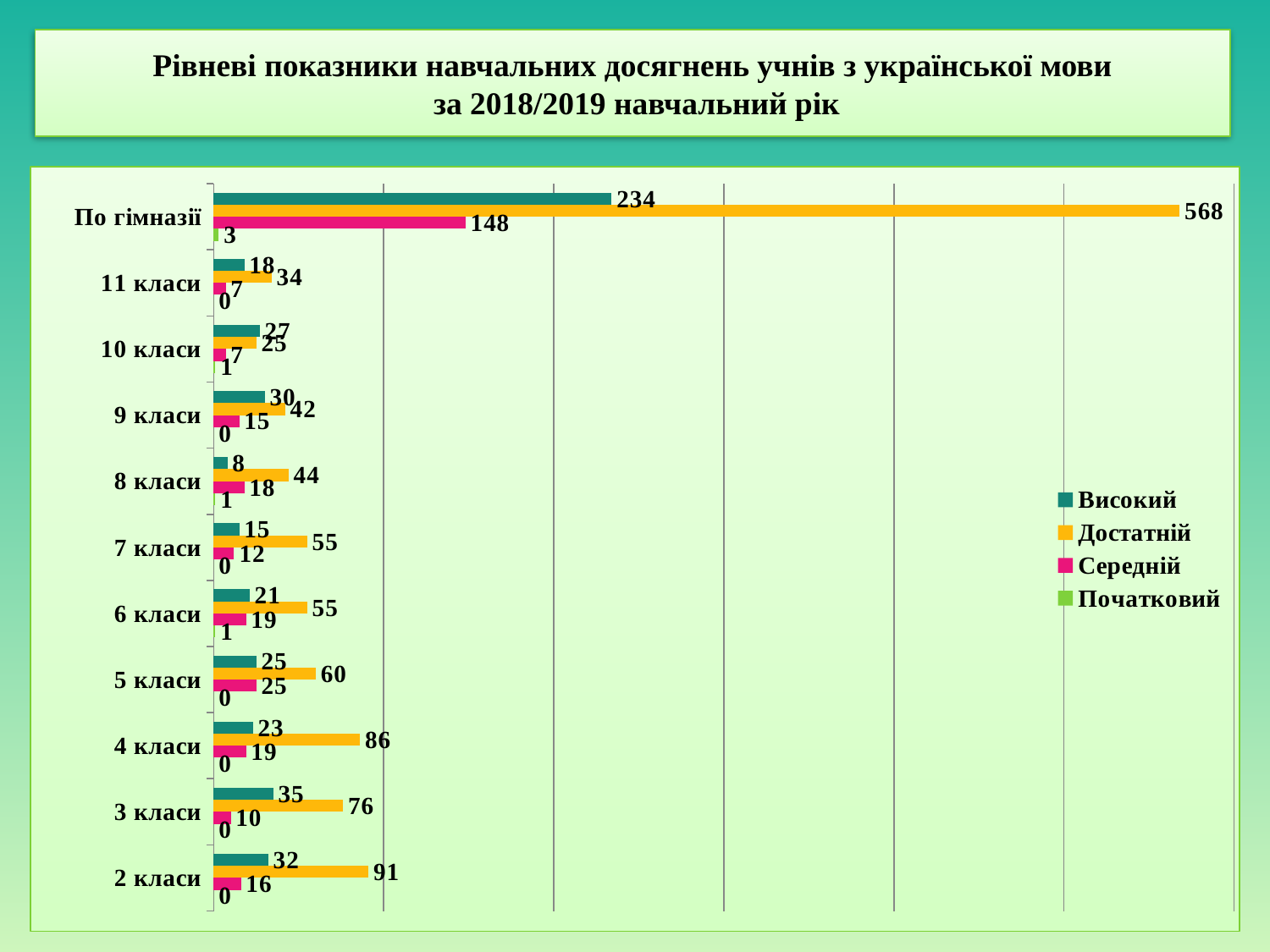
What is the value of Початковий for 10 класи? 1 Among the class categories (excluding По гімназії), which has the lowest Високий value? 8 класи What type of chart is shown on the slide? Bar chart What is the value of Середній for 8 класи? 18 Which is larger for 10 класи: the Високий value or the Достатній value? Високий What is the value of Високий for 3 класи? 35 What is the value of Достатній for По гімназії? 568 How many categories are shown on the vertical axis? 11 Which legend entry is shown in pink? Середній What is the difference between the Достатній and Високий values for По гімназії? 334 Among the class categories (excluding По гімназії), which has the highest Достатній value? 2 класи How many series does the legend list? 4